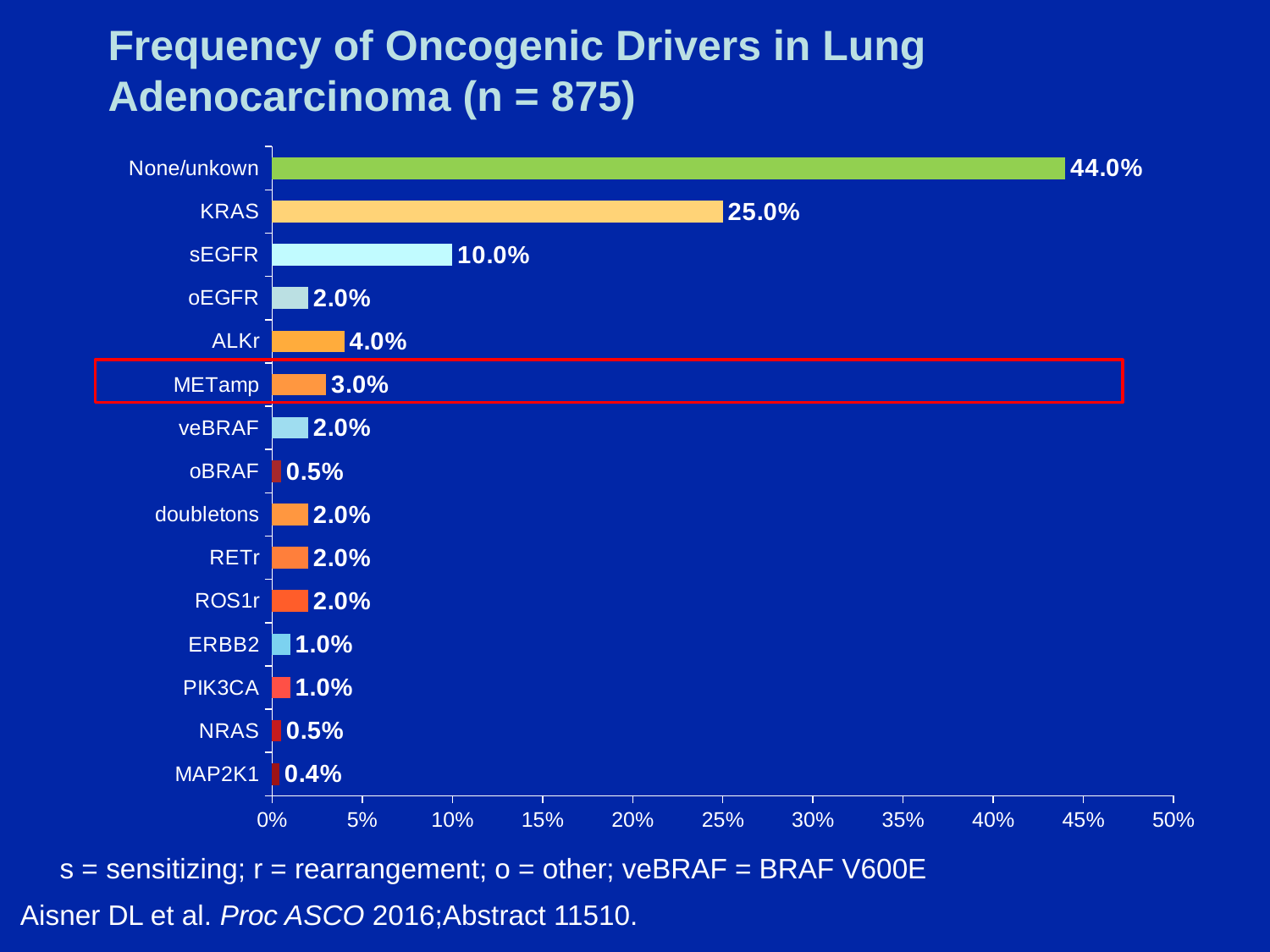
What is the value for MAP2K1? 0.4% How many categories are shown in the chart? 15 Which category is highlighted with a red box? METamp Which is larger, the value for ALKr or the value for veBRAF? ALKr What is the value for METamp? 3.0% Which category has the lowest value? MAP2K1 What is the difference between the values for ALKr and METamp? 1.0% What is the value for KRAS? 25.0% Which category has the highest value? None/unkown What is the value for sEGFR? 10.0% What kind of chart is shown on the slide? Bar chart What is the difference between the values for None/unkown and KRAS? 19.0%